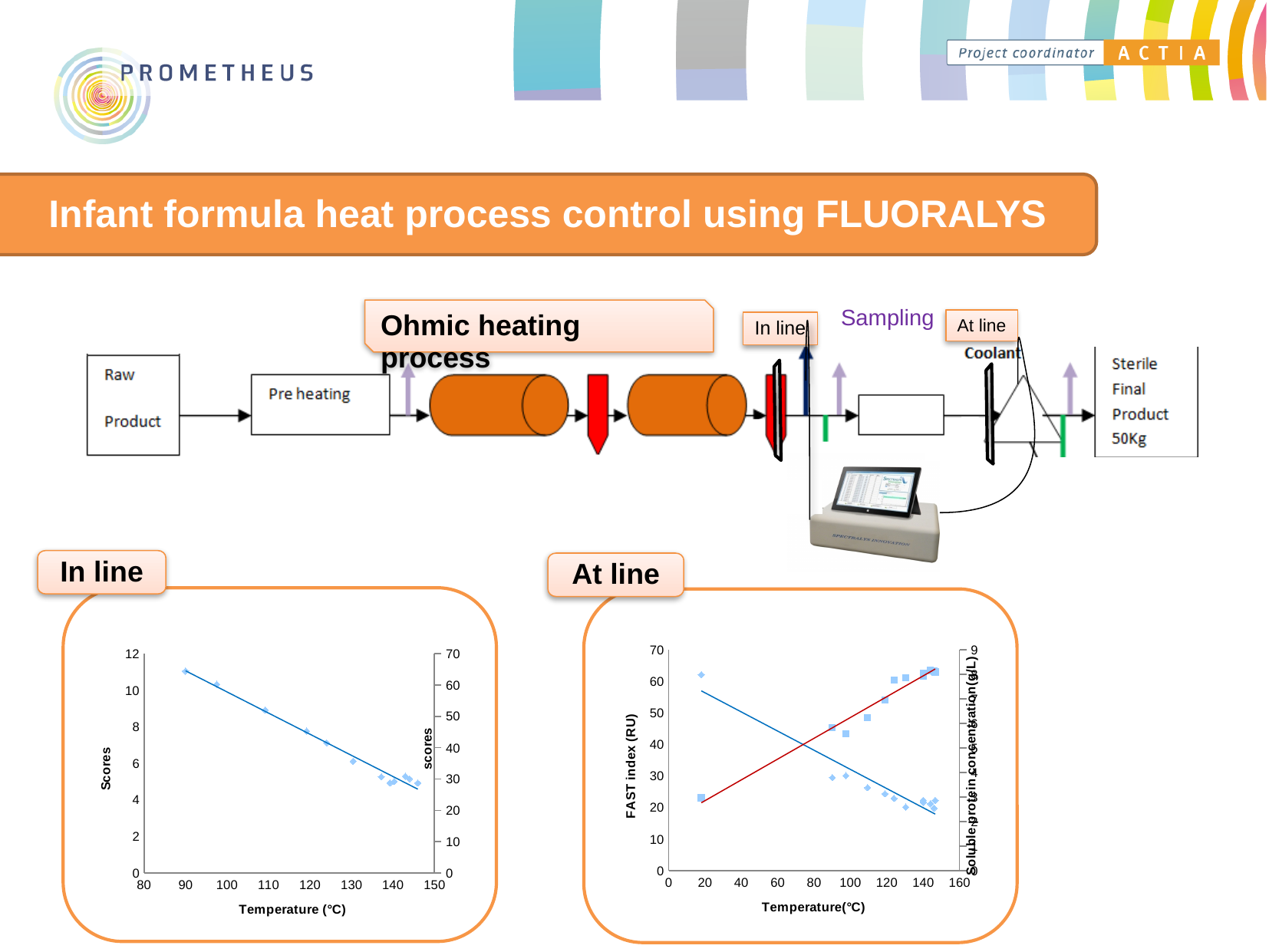
What kind of chart is the 'In line' chart? scatter chart What kind of chart is the 'At line' chart? scatter chart In the 'In line' chart, is the score at 140 °C greater or less than 6 on the left axis? less In the 'In line' chart, is the score at 90 °C greater or less than 10 on the left axis? greater What is the x-axis title of the 'In line' chart? Temperature (°C) What is the left y-axis title of the 'At line' chart? FAST index (RU) In the 'In line' chart, do the scores rise or fall as temperature increases? fall